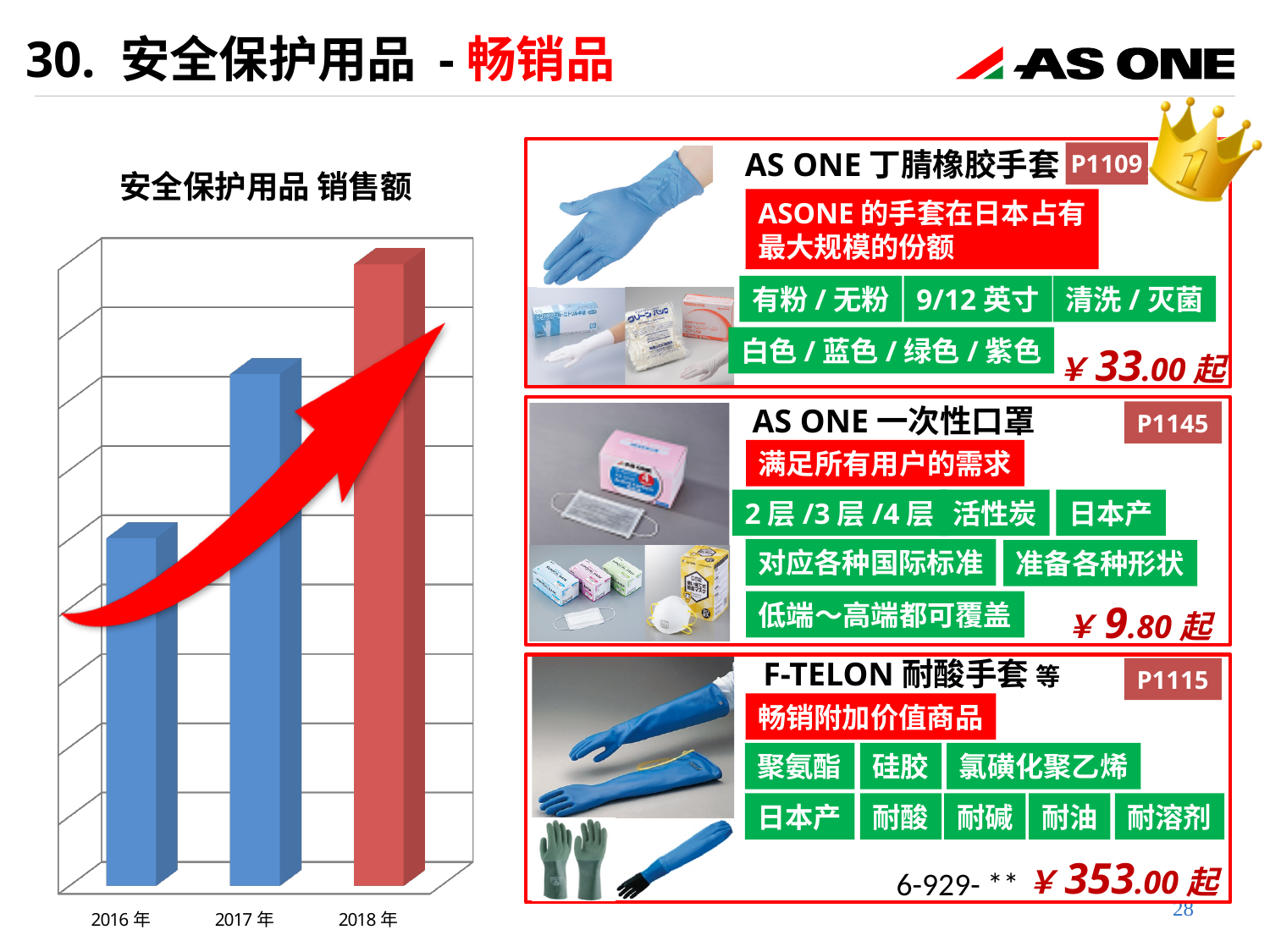
Do the values rise or fall from 2016 年 to 2018 年? rise Which year has the lowest bar in the chart? 2016 年 What colour is the bar for 2018 年? red How many categories are shown on the x axis of the chart? 3 What is the first category on the x axis of the chart? 2016 年 Which year has the highest bar in the chart? 2018 年 Which is larger, the bar for 2018 年 or the bar for 2017 年? 2018 年 Which is larger, the bar for 2017 年 or the bar for 2016 年? 2017 年 What kind of chart is shown on the slide? bar chart What is the title of the chart? 安全保护用品 销售额